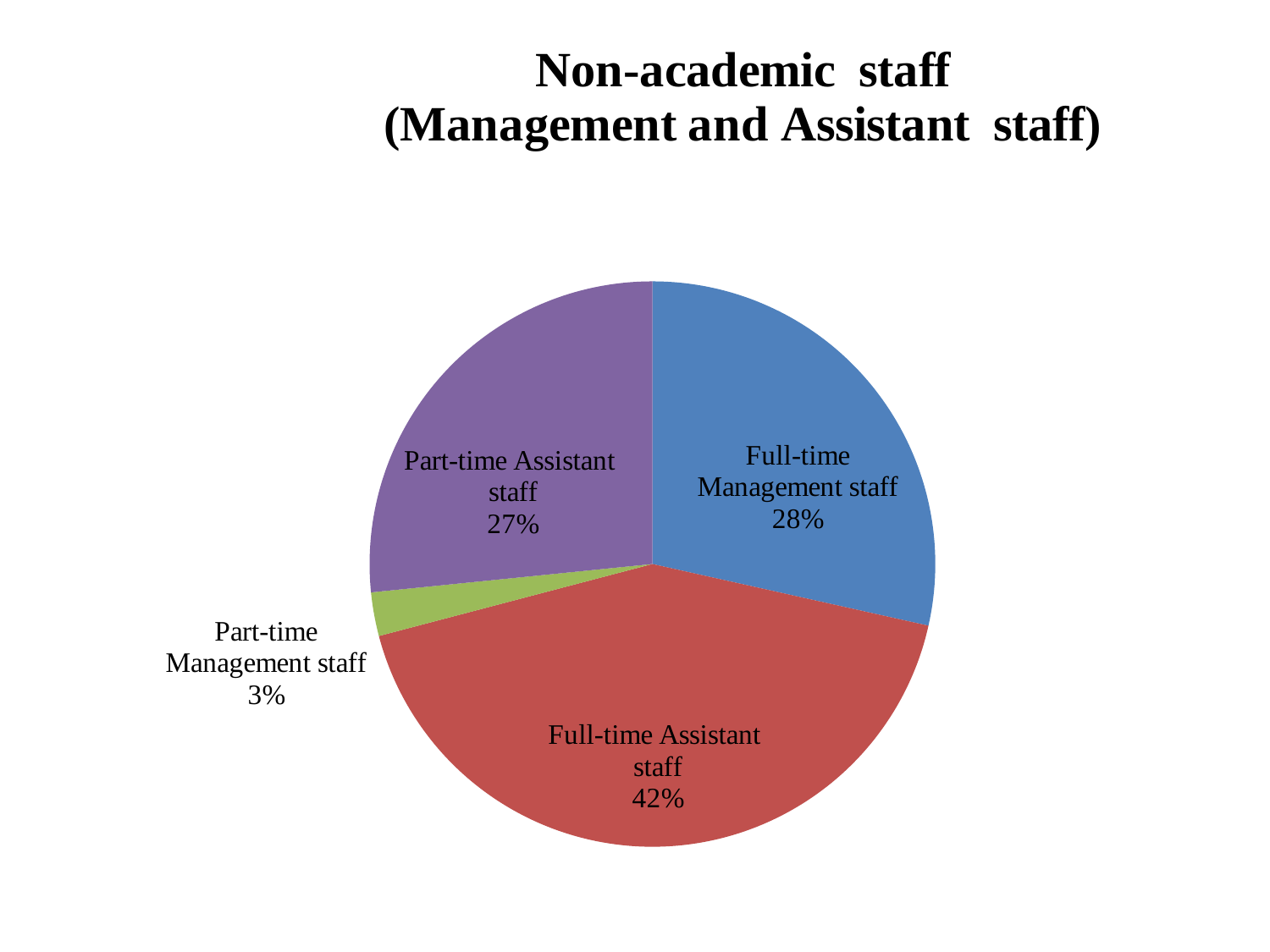
What is the difference in percentage points between Full-time Assistant staff and Part-time Assistant staff? 15 Which category has the largest share of the pie? Full-time Assistant staff What share of the pie is Part-time Management staff? 3% What type of chart is shown on the slide? pie chart What colour is the slice for Full-time Assistant staff? red What is the title of the chart? Non-academic staff (Management and Assistant staff) What share of the pie is Part-time Assistant staff? 27% Which is larger, the share for Full-time Management staff or the share for Part-time Management staff? Full-time Management staff What share of the pie is Full-time Management staff? 28% Which category has the smallest share of the pie? Part-time Management staff How many categories are shown in the pie chart? 4